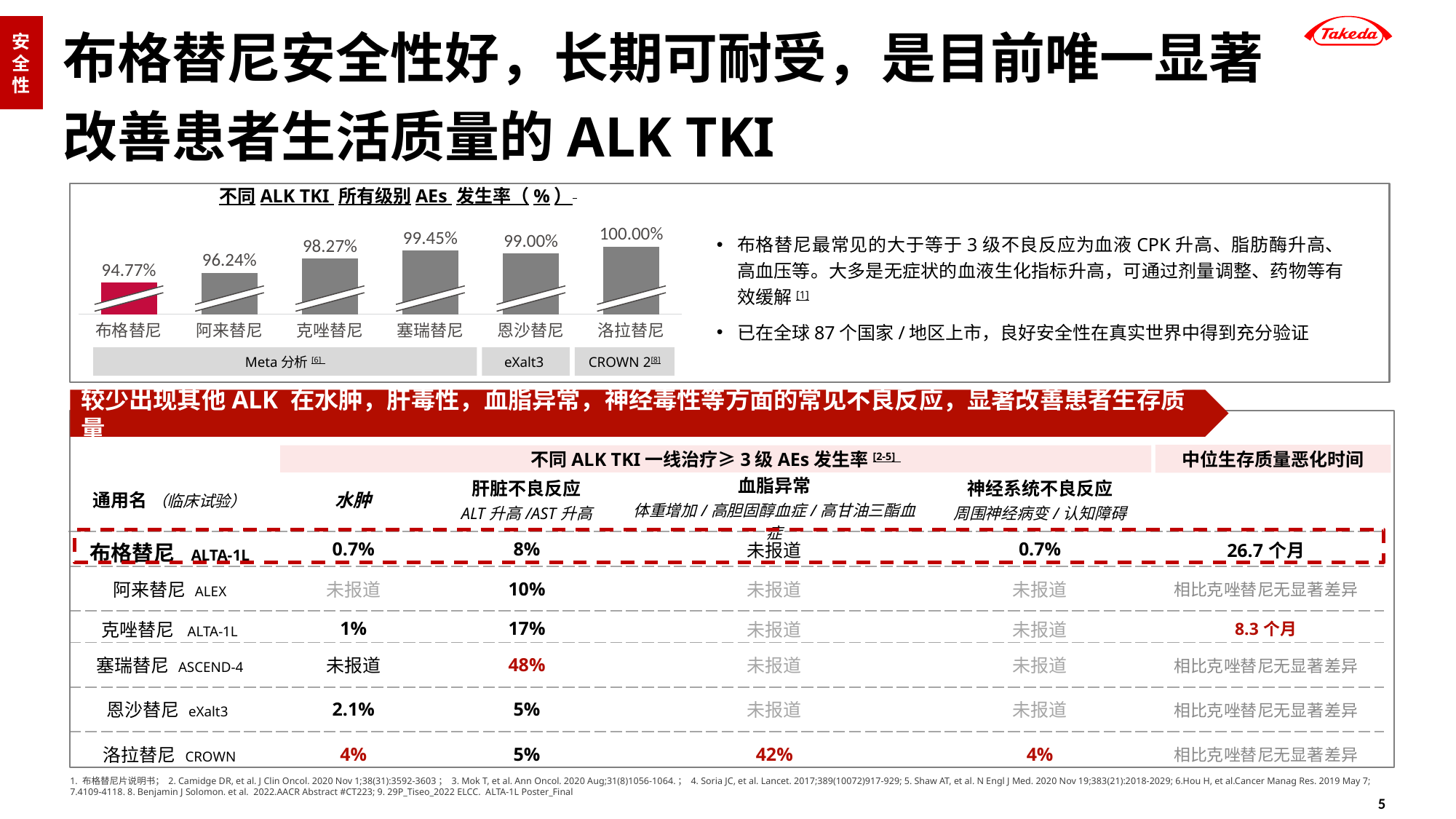
What value does the bar chart show for 洛拉替尼? 100.00% In the bar chart, which has a higher all-grade AE incidence, 阿来替尼 or 克唑替尼? 克唑替尼 What is the all-grade AE incidence shown for 布格替尼 in the bar chart? 94.77% What is the value labelled on the bar for 塞瑞替尼? 99.45% Which ALK TKI has the highest all-grade AE incidence in the bar chart? 洛拉替尼 Which ALK TKI has the lowest all-grade AE incidence in the bar chart? 布格替尼 What type of chart is used to show the all-grade AE incidence of different ALK TKIs? Bar chart What is the difference between the values for 洛拉替尼 and 布格替尼 in the bar chart? 5.23% What is the value labelled on the bar for 恩沙替尼? 99.00% How many ALK TKIs are shown as bars in the chart? 6 Which bar in the chart is highlighted in red rather than grey? 布格替尼 What is the difference between the values for 克唑替尼 and 阿来替尼 in the bar chart? 2.03%